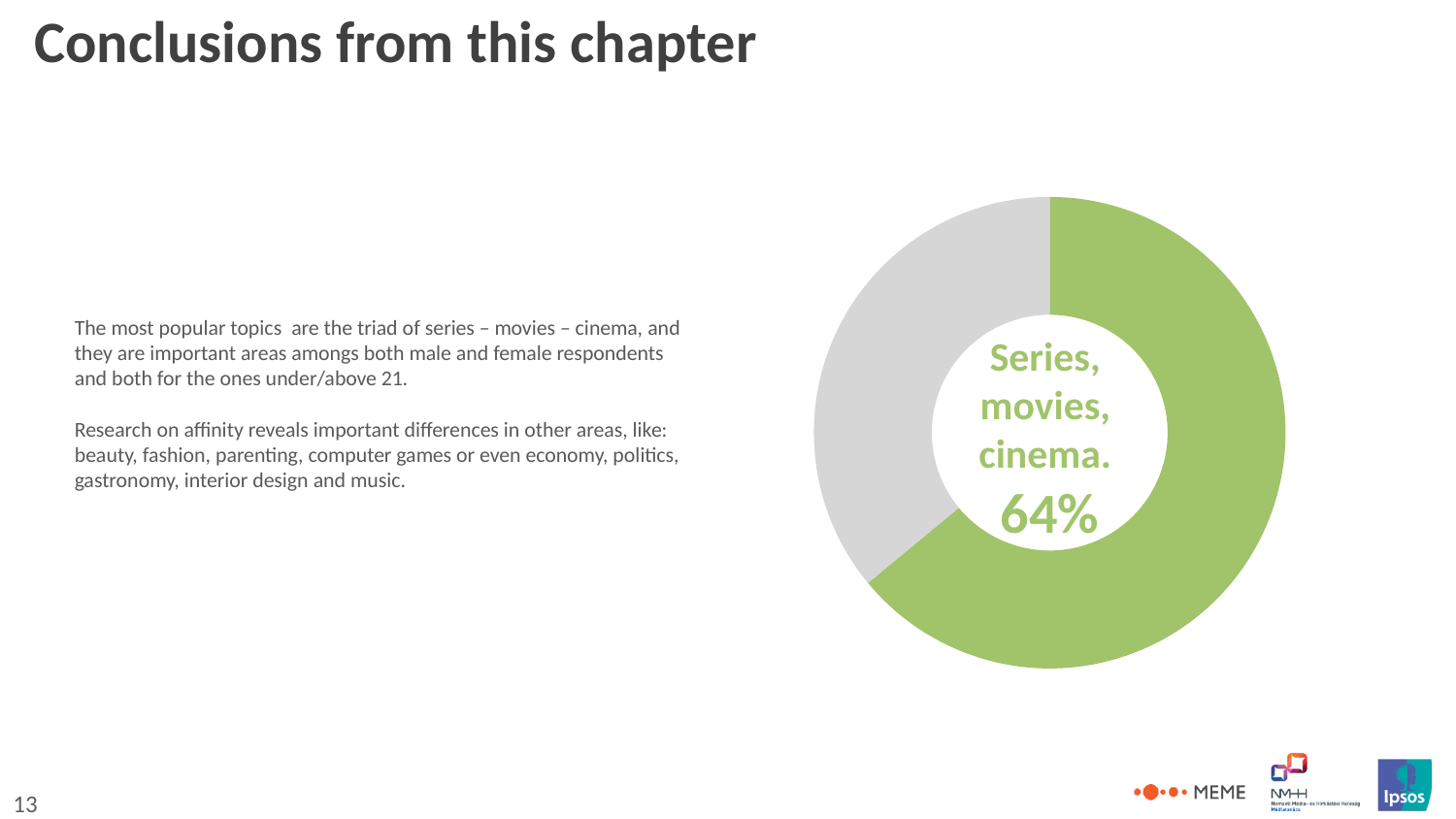
Is the value for Series, movies, cinema greater or less than 50%? greater What kind of chart is shown on the slide? Pie chart (donut) What share of the pie chart is labelled "Series, movies, cinema"? 64% Which slice of the donut chart is larger, the green one or the grey one? The green one How many slices does the donut chart have? 2 What value is printed in the centre of the donut chart? 64% Which topic group does the donut chart's 64% refer to? Series, movies, cinema What colour is the slice representing Series, movies, cinema? Green